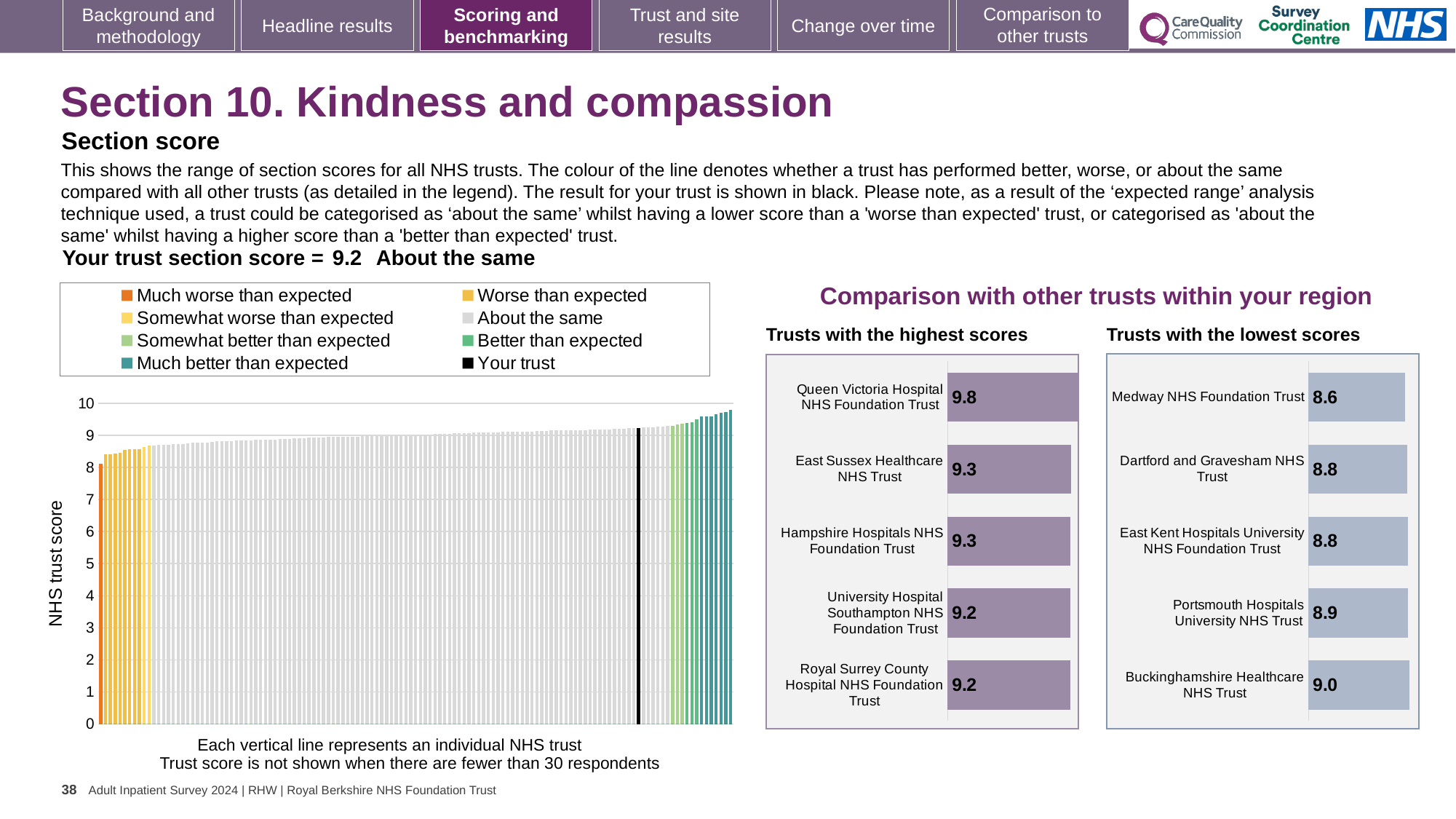
In the 'Trusts with the lowest scores' chart, what is the score for Buckinghamshire Healthcare NHS Trust? 9.0 How many trusts are shown in the 'Trusts with the lowest scores' chart? 5 In the 'Trusts with the highest scores' chart, what is the score for Queen Victoria Hospital NHS Foundation Trust? 9.8 In the NHS trust score chart, is the value of the leftmost (orange) bar greater or less than 9? less In the 'Trusts with the highest scores' chart, what is the difference between the scores of Queen Victoria Hospital NHS Foundation Trust and Royal Surrey County Hospital NHS Foundation Trust? 0.6 What kind of chart is the NHS trust score chart on the left of the slide? bar chart In the NHS trust score chart, do the trust scores rise or fall from left to right? rise In the 'Trusts with the lowest scores' chart, which has the larger score: Portsmouth Hospitals University NHS Trust or Dartford and Gravesham NHS Trust? Portsmouth Hospitals University NHS Trust In the 'Trusts with the lowest scores' chart, which trust has the lowest score? Medway NHS Foundation Trust In the 'Trusts with the highest scores' chart, which trust has the highest score? Queen Victoria Hospital NHS Foundation Trust How many entries does the legend of the NHS trust score chart list? 8 In the 'Trusts with the lowest scores' chart, what is the score for Medway NHS Foundation Trust? 8.6